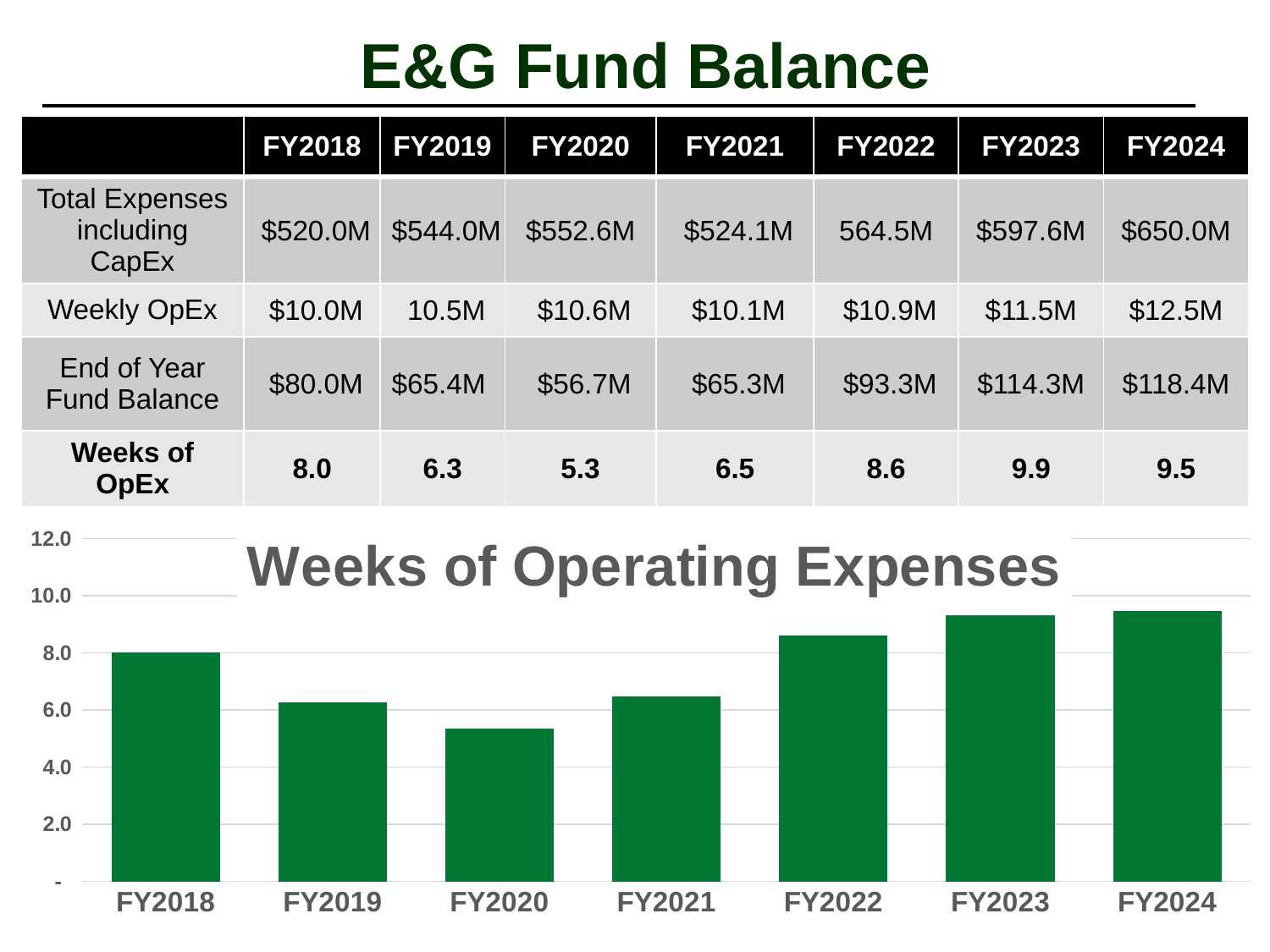
Which is larger in the chart, the value for FY2021 or the value for FY2022? FY2022 Do the values in the chart rise or fall from FY2020 to FY2023? rise What is the difference between the values for FY2023 and FY2020 in the chart? 4.6 Which fiscal year has the lowest weeks of operating expenses in the chart? FY2020 How many fiscal years are plotted in the chart? 7 Is the value for FY2022 greater or less than 8.0? greater Which fiscal year has the highest weeks of operating expenses in the chart? FY2023 What is the value for FY2018 in the chart? 8.0 What type of chart is shown on the slide? bar chart Is the value for FY2019 greater or less than 8.0? less What is the value for FY2020 in the chart? 5.3 What is the title of the chart? Weeks of Operating Expenses